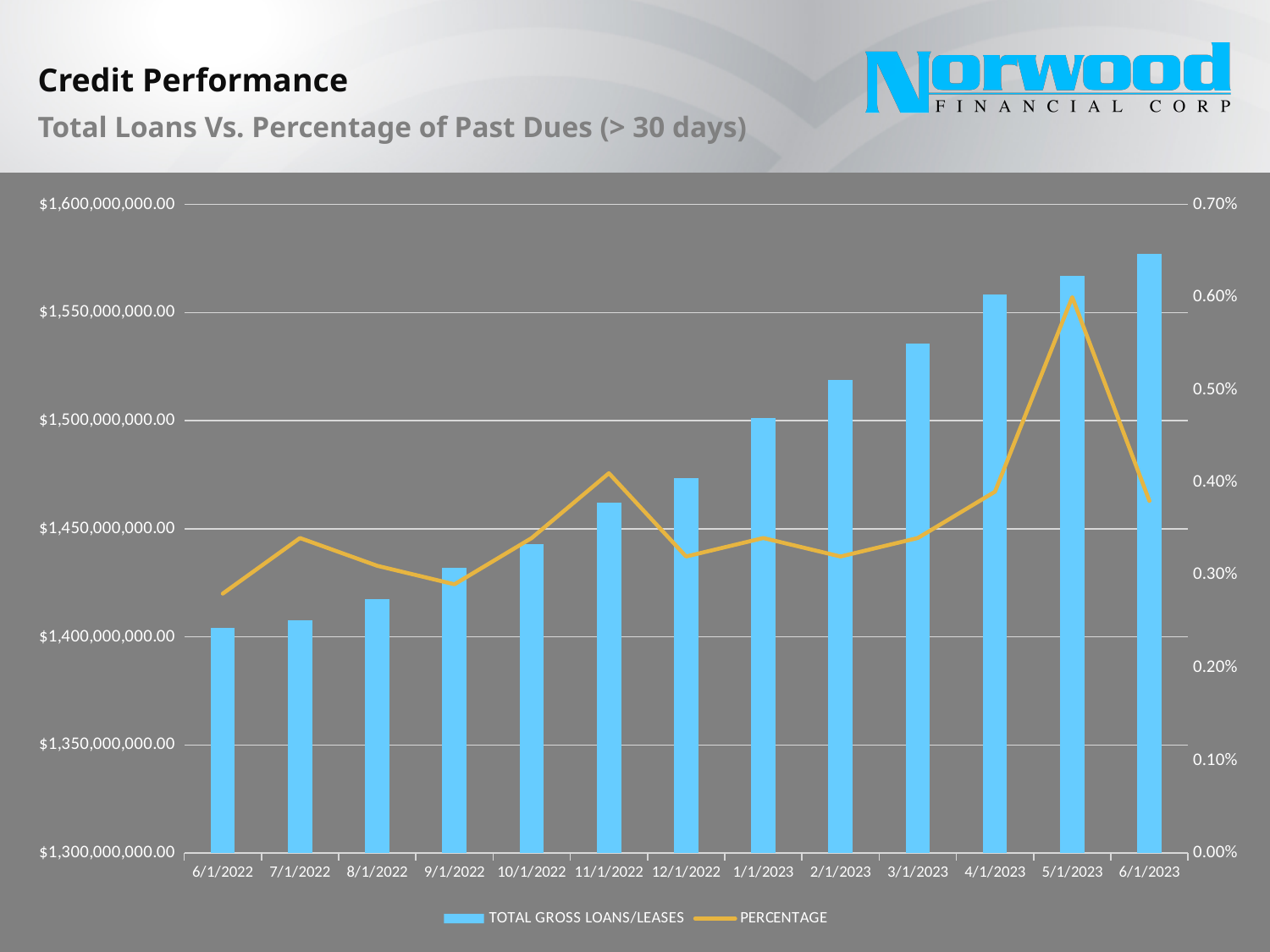
On which date does the PERCENTAGE line reach its highest point? 5/1/2023 Which date has the lowest TOTAL GROSS LOANS/LEASES bar? 6/1/2022 How many dates are shown along the x axis of the chart? 13 Which has the larger TOTAL GROSS LOANS/LEASES bar, 12/1/2022 or 1/1/2023? 1/1/2023 Do the TOTAL GROSS LOANS/LEASES bars generally rise or fall from 6/1/2022 to 6/1/2023? rise Is the TOTAL GROSS LOANS/LEASES value for 6/1/2023 greater or less than $1,550,000,000.00? greater Is the PERCENTAGE value for 5/1/2023 greater or less than 0.50%? greater How many series does the chart legend list? 2 Which date has the highest TOTAL GROSS LOANS/LEASES bar? 6/1/2023 Is the TOTAL GROSS LOANS/LEASES value for 6/1/2022 greater or less than $1,450,000,000.00? less What type of chart is shown on the slide? A combination bar and line chart What is the subtitle of the chart on the slide? Total Loans Vs. Percentage of Past Dues (> 30 days)